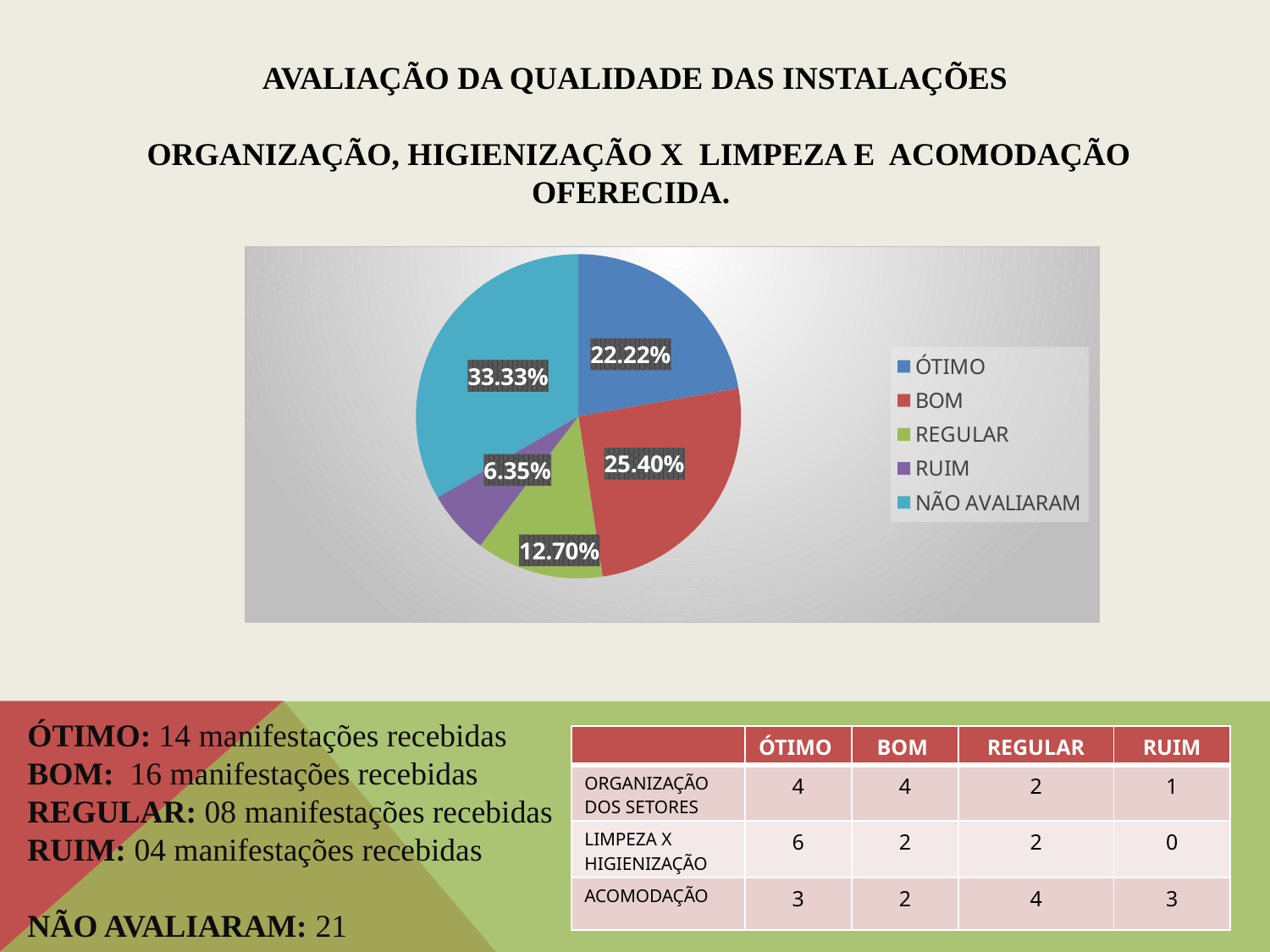
Which category has the smallest slice of the pie? RUIM What share of the pie does REGULAR represent? 12.70% What share of the pie does ÓTIMO represent? 22.22% What kind of chart is shown on the slide? Pie chart Which slice is larger, BOM or ÓTIMO? BOM What share of the pie does NÃO AVALIARAM represent? 33.33% Which category has the largest slice of the pie? NÃO AVALIARAM What is the difference in percentage points between NÃO AVALIARAM and RUIM? 26.98% What share of the pie does BOM represent? 25.40% What share of the pie does RUIM represent? 6.35% How many entries does the legend list? 5 How many slices does the pie chart have? 5